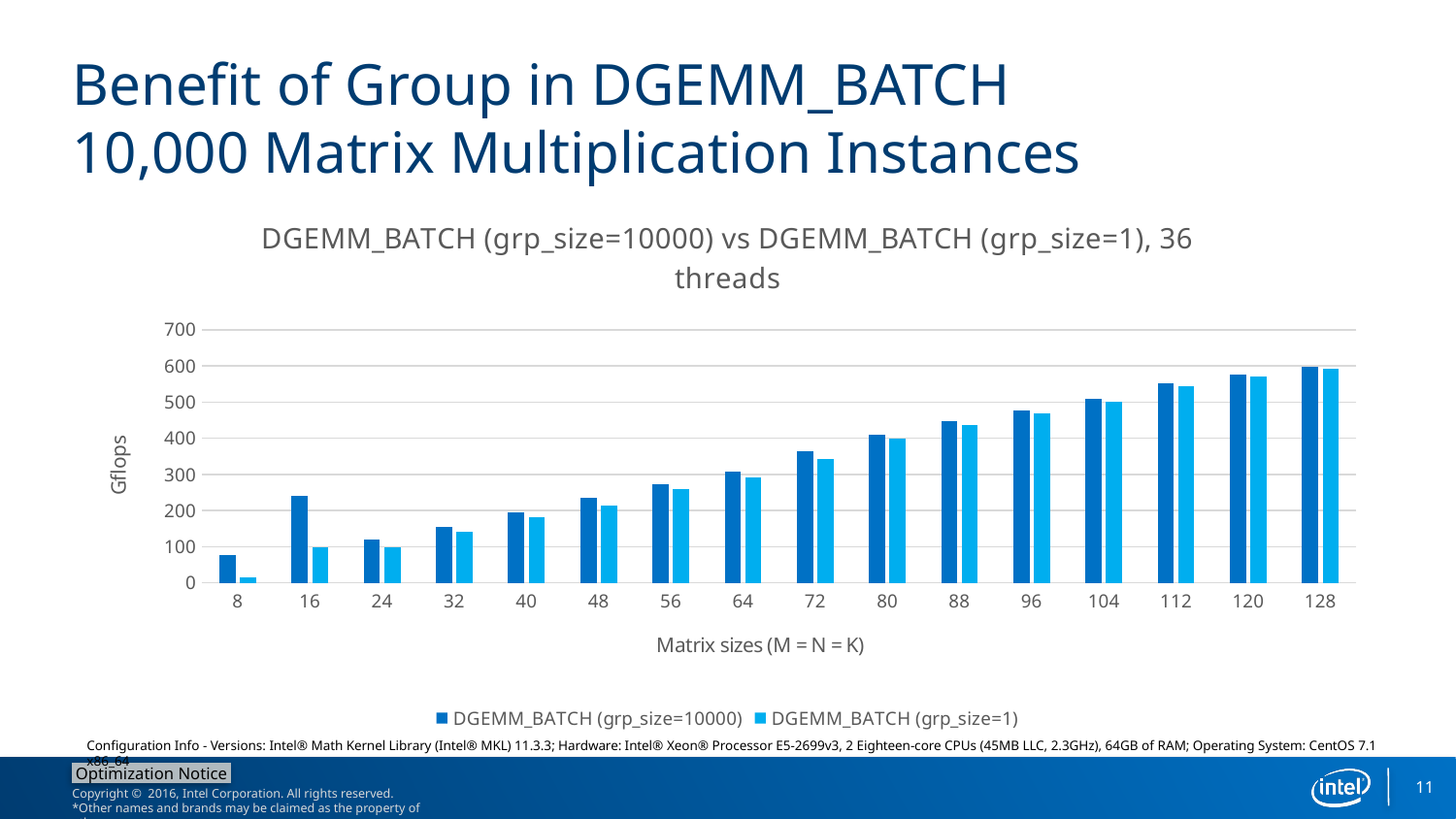
How many matrix sizes are shown along the x axis? 16 Is the Gflops value for DGEMM_BATCH (grp_size=1) at matrix size 8 greater or less than 100? less What is the label of the y axis of the chart? Gflops Which matrix size has the highest Gflops for DGEMM_BATCH (grp_size=10000)? 128 How many series does the legend list? 2 Is the Gflops value for DGEMM_BATCH (grp_size=1) at matrix size 128 greater or less than 500? greater Which matrix size has the lowest Gflops for DGEMM_BATCH (grp_size=1)? 8 Is the Gflops value for DGEMM_BATCH (grp_size=10000) at matrix size 96 greater or less than 500? less Do the Gflops values for DGEMM_BATCH (grp_size=1) rise or fall as the matrix size increases from 8 to 128? rise At matrix size 8, which series has the higher Gflops: DGEMM_BATCH (grp_size=10000) or DGEMM_BATCH (grp_size=1)? DGEMM_BATCH (grp_size=10000) What kind of chart is shown on the slide? bar chart